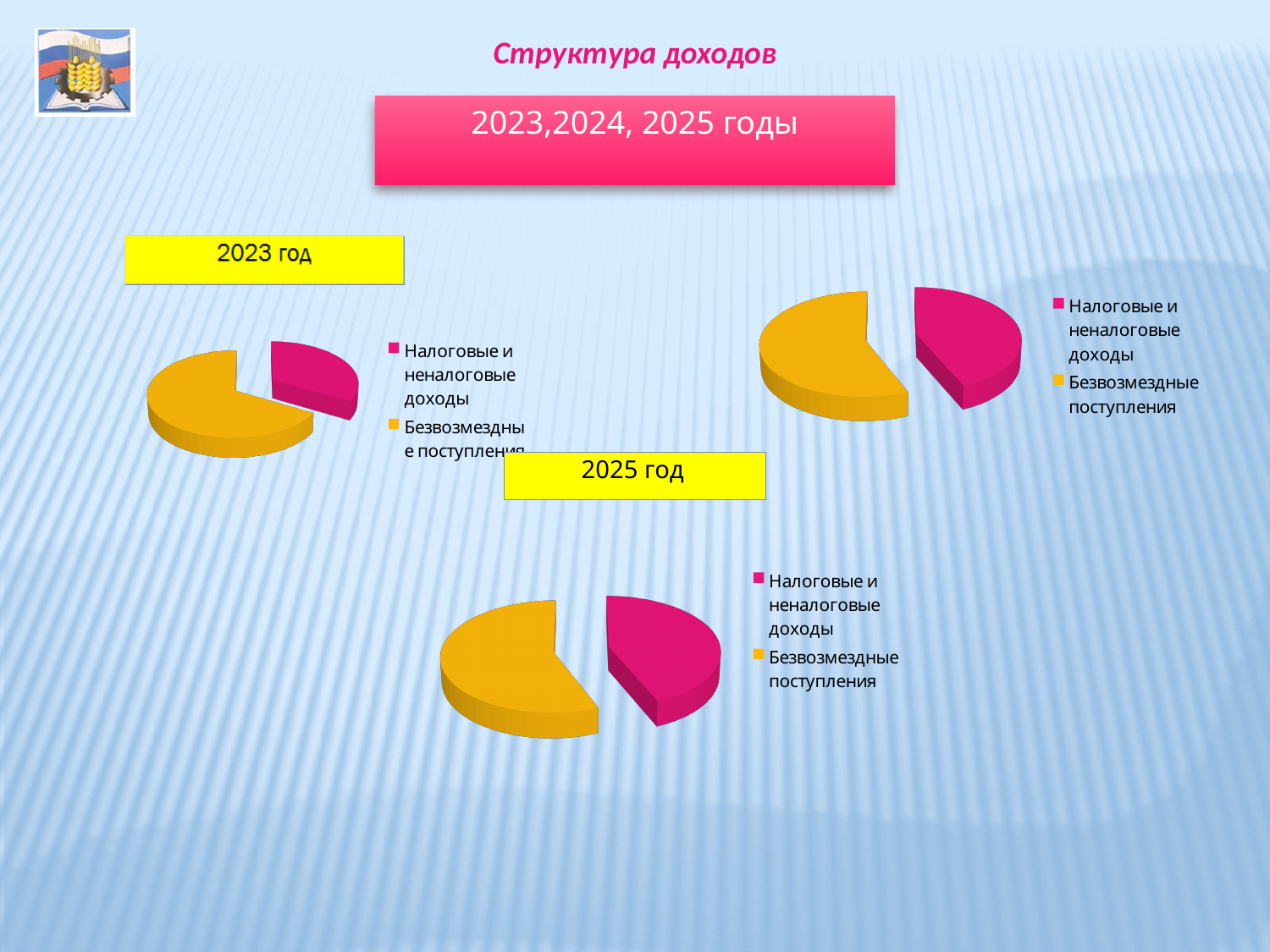
In the 2023 год pie chart on the left, which category has the smallest slice? Налоговые и неналоговые доходы How many entries does the legend of the 2023 год pie chart list? 2 In the 2025 год pie chart at the bottom of the slide, which category has the largest slice? Безвозмездные поступления In the 2023 год pie chart on the left, which category has the largest slice? Безвозмездные поступления What kind of chart is used for the 2023 год chart on the left of the slide? Pie chart In the 2023 год pie chart on the left, which slice is larger: Налоговые и неналоговые доходы or Безвозмездные поступления? Безвозмездные поступления How many slices does the pie chart at the top right of the slide have? 2 In the 2025 год pie chart at the bottom of the slide, which category has the smallest slice? Налоговые и неналоговые доходы In the pie chart at the top right of the slide, which slice is larger: Налоговые и неналоговые доходы or Безвозмездные поступления? Безвозмездные поступления How many slices does the 2023 год pie chart on the left have? 2 In the 2025 год pie chart at the bottom of the slide, what colour is the slice for Налоговые и неналоговые доходы? Pink How many pie charts are shown on the slide? 3